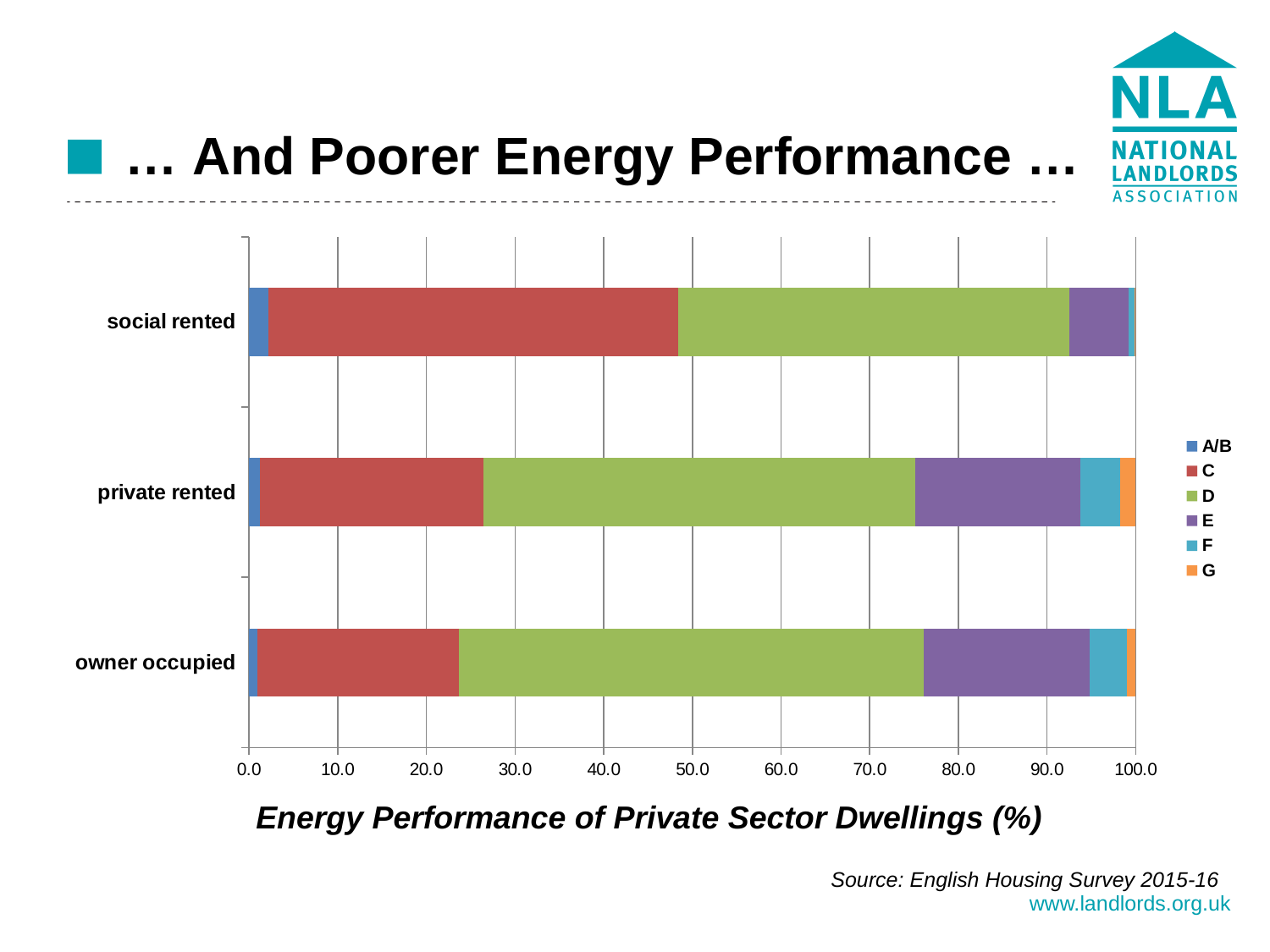
Which has the larger E segment, social rented or private rented? private rented Which tenure category has the smallest D segment? social rented Which energy rating band is shown in green in the legend? D Is the D segment for private rented greater or less than 40? greater Which tenure category has the largest C segment? social rented Is the C segment for social rented greater or less than 40? greater How many tenure categories are plotted on the chart? 3 What is the title printed below the chart? Energy Performance of Private Sector Dwellings (%) How many series does the legend list? 6 What kind of chart is shown on the slide? Stacked bar chart Is the C segment for owner occupied greater or less than 30? less